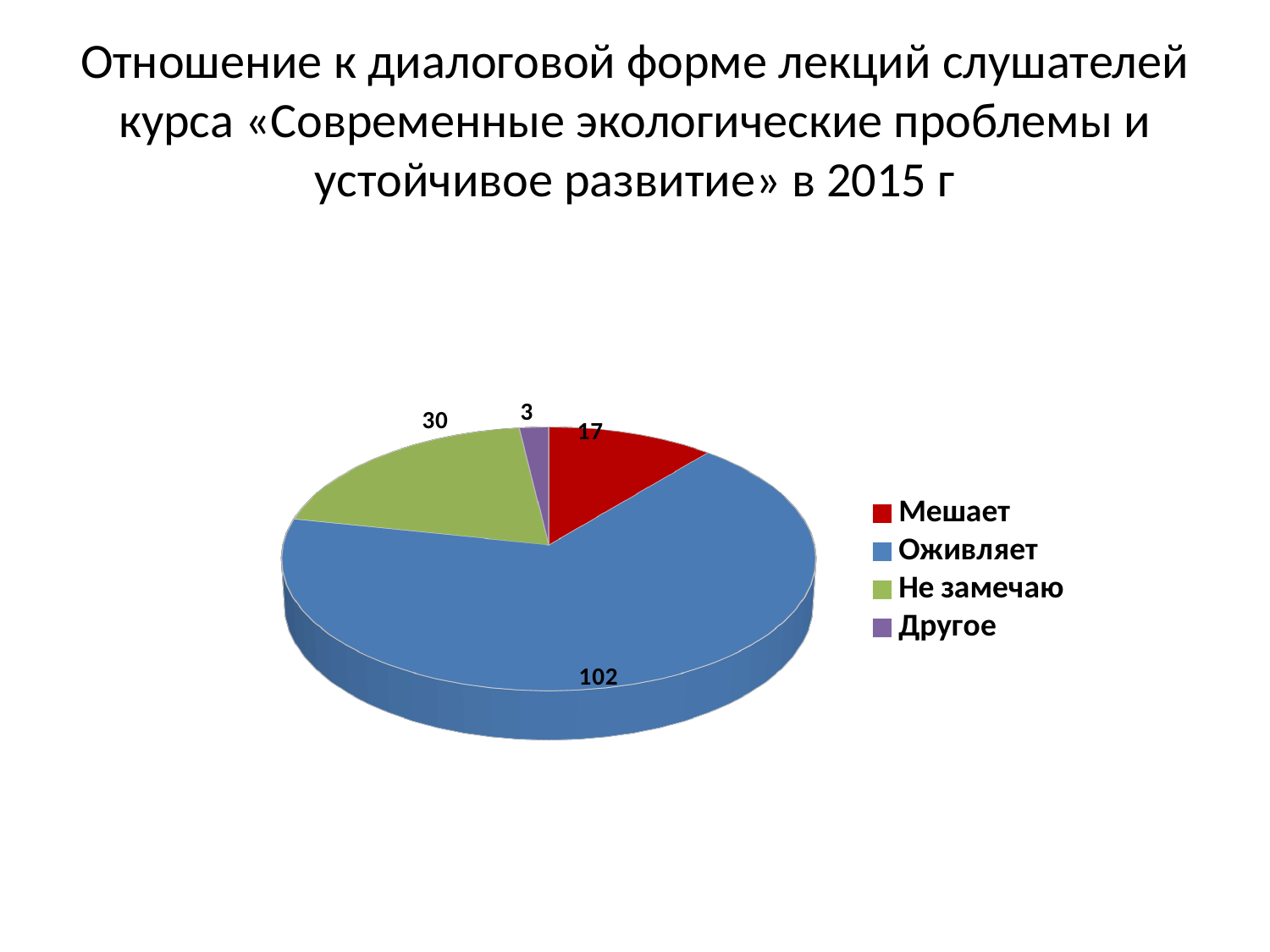
What value is shown for the "Не замечаю" slice? 30 Which category has the smallest slice of the pie? Другое What colour is the "Оживляет" slice in the pie chart? Blue What value is shown for the "Другое" slice? 3 How many categories does the pie chart show? 4 What kind of chart is shown on the slide? Pie chart What is the difference between the values for "Оживляет" and "Не замечаю"? 72 What value is shown for the "Мешает" slice? 17 Which is larger, the value for "Мешает" or the value for "Не замечаю"? Не замечаю What is the total of all the values shown in the pie chart? 152 What value is shown for the "Оживляет" slice? 102 Which category has the largest slice of the pie? Оживляет